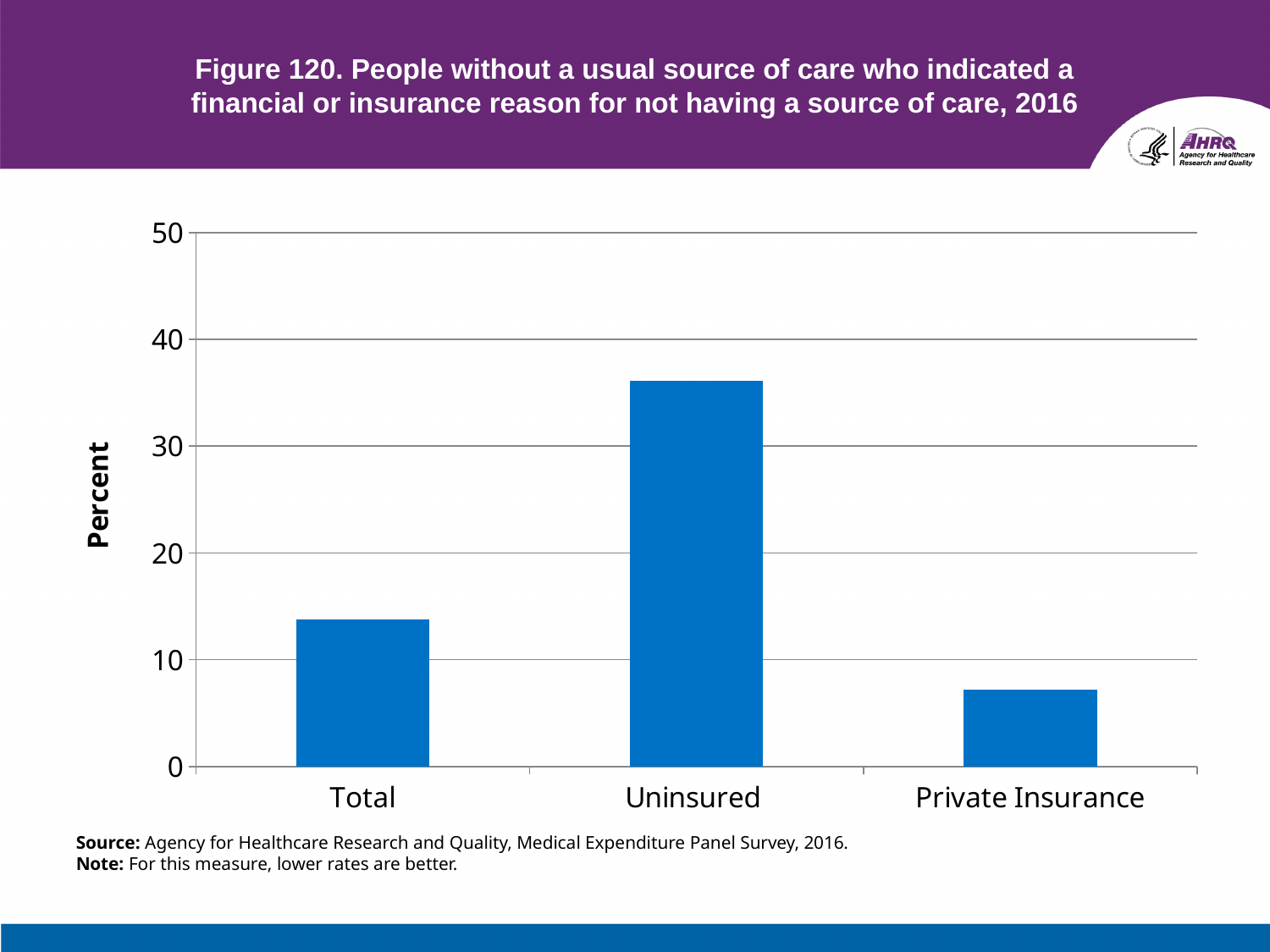
Which is larger, the value for Uninsured or the value for Total? Uninsured How many categories are shown on the x axis? 3 Which category has the highest value? Uninsured Which is larger, the value for Total or the value for Private Insurance? Total What kind of chart is shown on the slide? bar chart Is the value for Total greater or less than 10? greater Is the value for Private Insurance greater or less than 10? less Which category has the lowest value? Private Insurance What is the maximum value shown on the y axis? 50 Is the value for Uninsured greater or less than 30? greater What is the label of the y axis? Percent